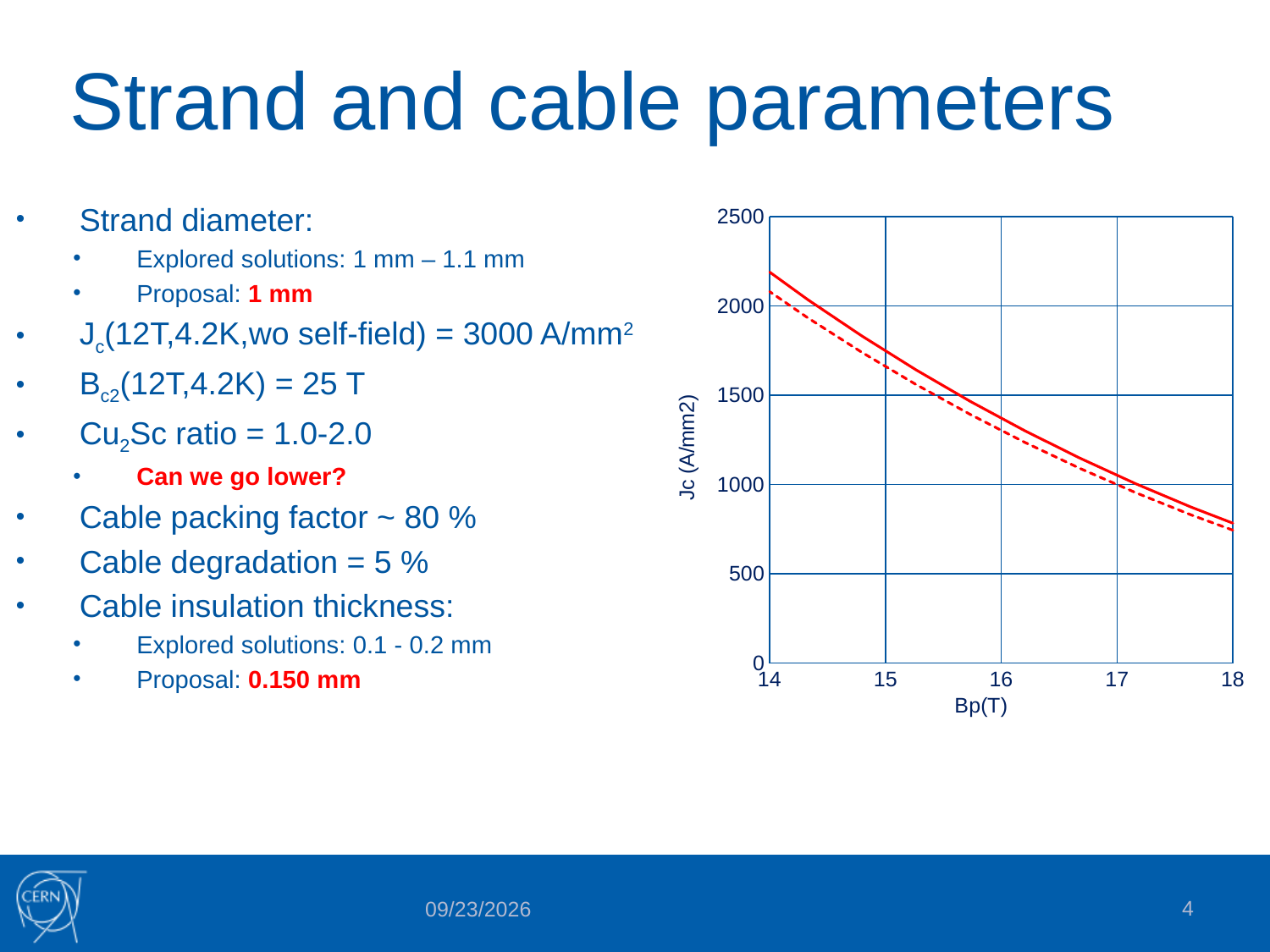
How many lines are plotted on the chart? 2 Is the value of the solid line at Bp = 16 T greater or less than 1500 A/mm2? less Is the value of the solid line at Bp = 14 T greater or less than 2000 A/mm2? greater What kind of chart is shown on the slide? line chart Is the value of the solid line at Bp = 18 T greater or less than 1000 A/mm2? less What is the label of the y axis of the chart? Jc (A/mm2) Do the Jc values rise or fall as Bp increases from 14 to 18 T? fall What is the label of the x axis of the chart? Bp(T) Which line lies higher on the chart, the solid line or the dashed line? the solid line